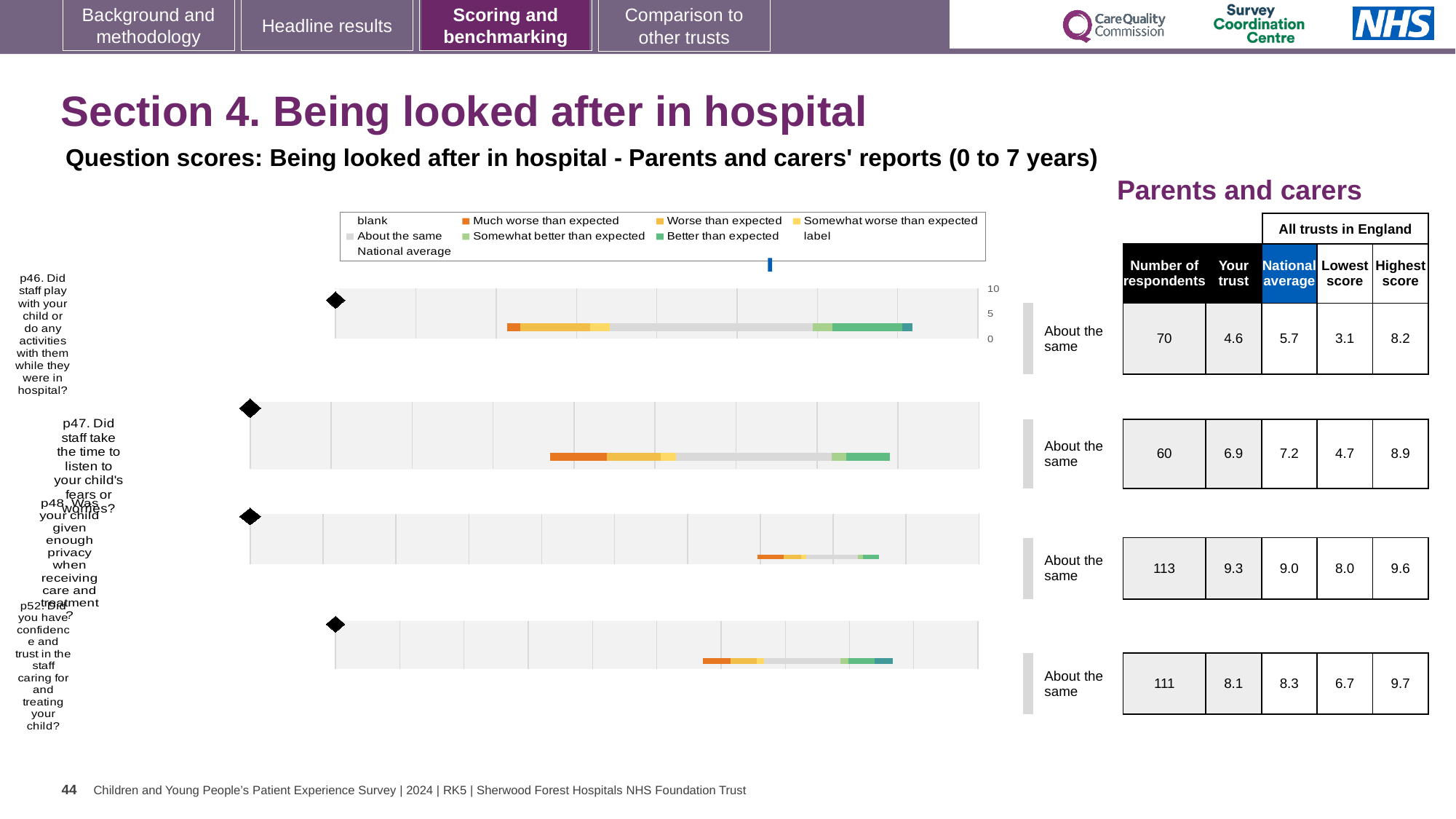
For p46, which is larger: the trust's score or the national average? National average What is the highest score among all trusts in England for p52 (confidence and trust in staff)? 9.7 What is the difference between the national average and the trust's score for p47? 0.3 How many respondents answered p46 (did staff play with your child)? 70 Which question has the lowest 'Your trust' score? p46 What benchmark category is shown for all four questions? About the same According to the table, what is the 'Your trust' score for p48 (privacy when receiving care and treatment)? 9.3 Which question has the highest 'Your trust' score? p48 What kind of chart is used to show the question scores on this slide? bar chart Which colour in the legend represents 'Much worse than expected'? Orange According to the table, what is the national average for p47 (staff taking time to listen to your child's fears or worries)? 7.2 How many survey questions (bars) are plotted on the slide? 4